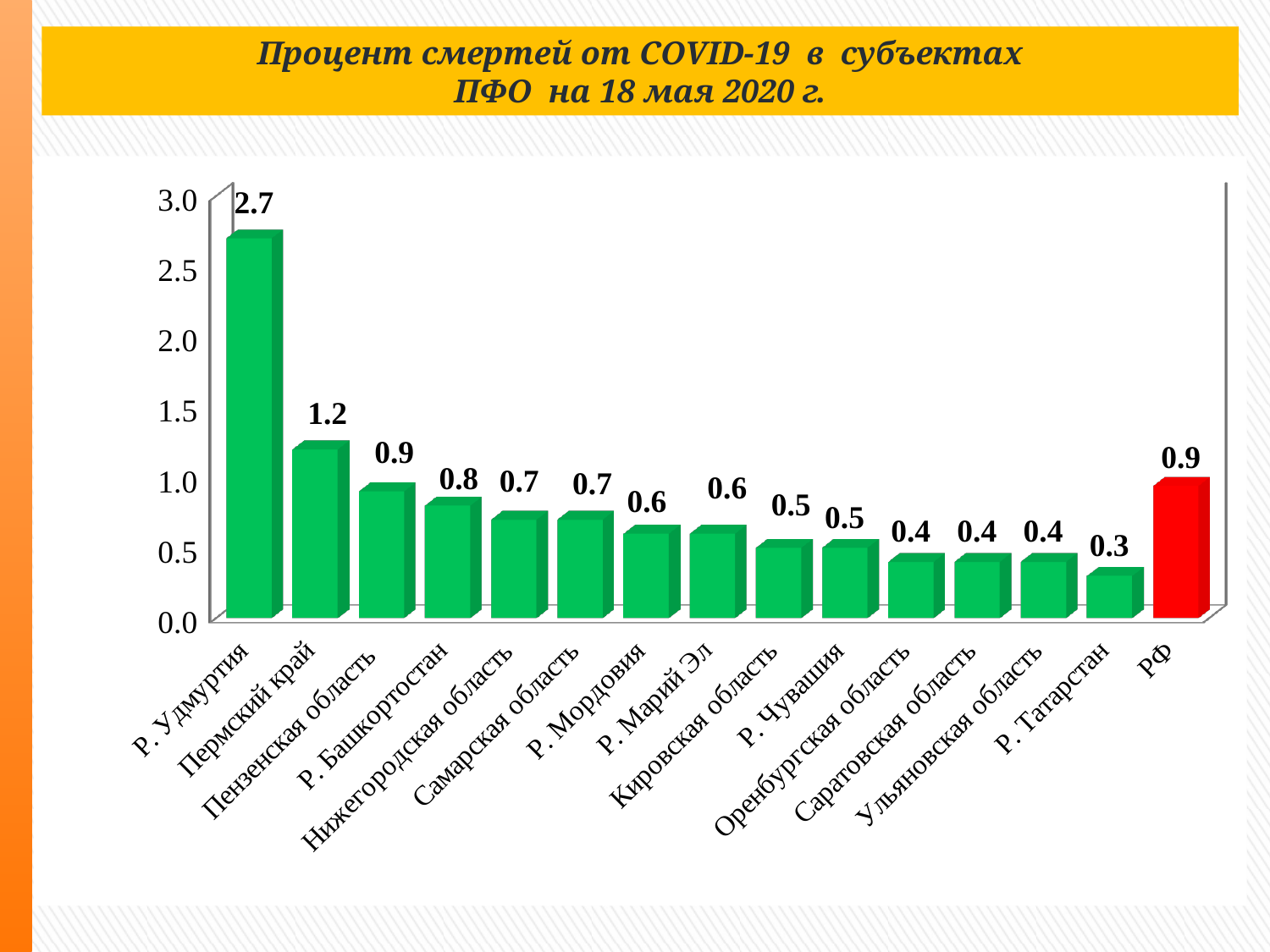
What is the difference between the values for Р. Удмуртия and Пермский край? 1.5 What is the difference between the values for РФ and Р. Татарстан? 0.6 How many bars are plotted on the chart? 15 Which bar is coloured red rather than green? РФ Which is larger, the value for Р. Башкортостан or the value for Р. Мордовия? Р. Башкортостан Which category has the lowest value? Р. Татарстан What is the value for РФ? 0.9 What type of chart is shown on the slide? bar chart Which category has the highest value? Р. Удмуртия What is the value for Р. Татарстан? 0.3 What is the value for Р. Удмуртия? 2.7 What is the value for Пермский край? 1.2